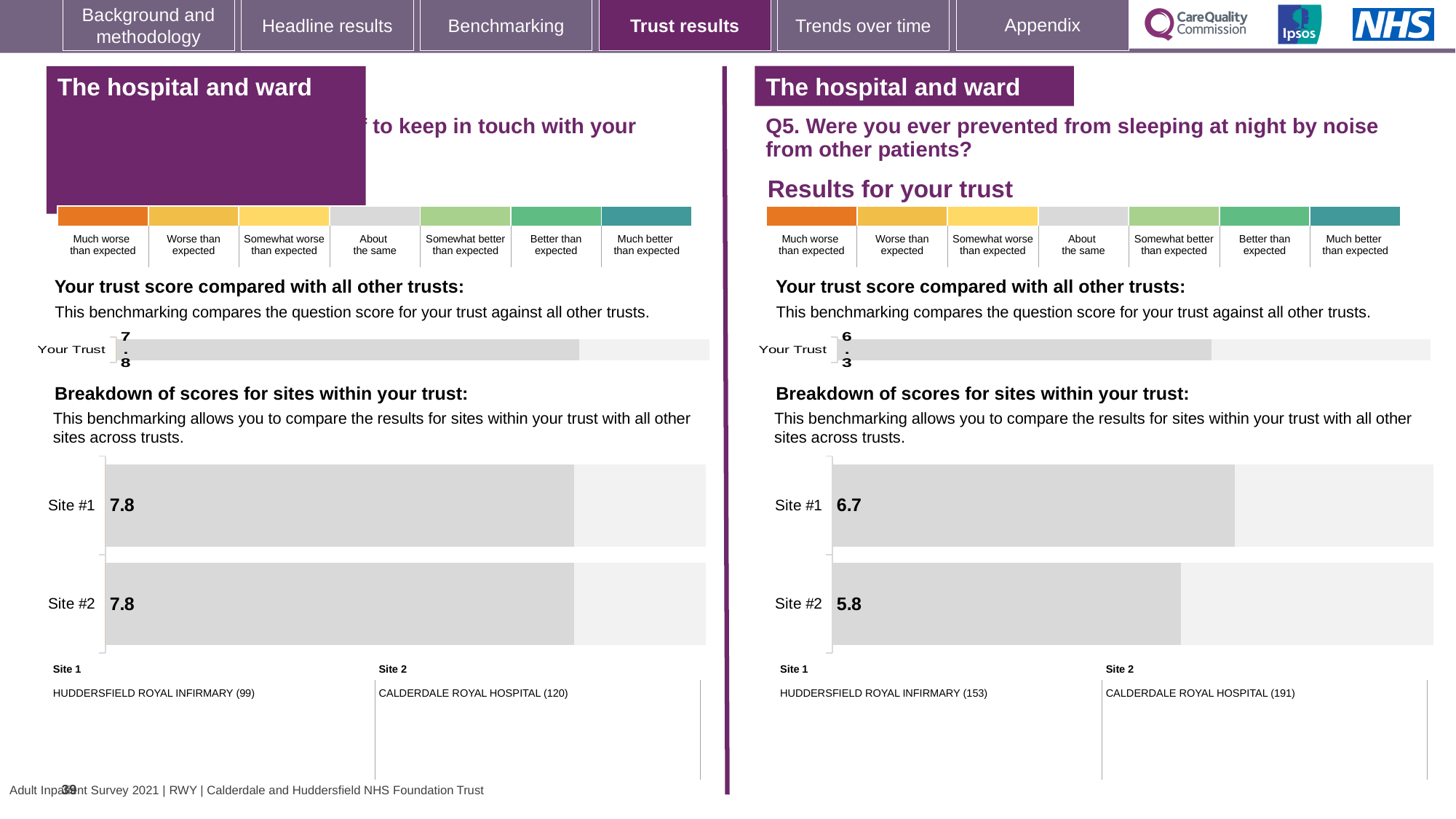
On the right-hand 'Your trust score compared with all other trusts' chart, what is the score shown for Your Trust? 6.3 On the right-hand chart (Q5, noise from other patients), what is the score for Site #1? 6.7 On the left-hand 'Your trust score compared with all other trusts' chart, what is the score shown for Your Trust? 7.8 On the right-hand site breakdown chart, which site has the lower score? Site #2 On the left-hand site breakdown chart, what is the score for Site #2? 7.8 On the right-hand chart (Q5, noise from other patients), what is the score for Site #2? 5.8 On the right-hand site breakdown chart, is the score for Site #1 larger or smaller than the score for Site #2? larger On the right-hand site breakdown chart, what is the difference between the Site #1 and Site #2 scores? 0.9 How many sites are shown in the right-hand site breakdown chart? 2 On the right-hand site breakdown chart, which site has the higher score? Site #1 What type of chart is used for the site breakdown on the right-hand side of the slide? bar chart On the left-hand site breakdown chart, what is the score for Site #1? 7.8